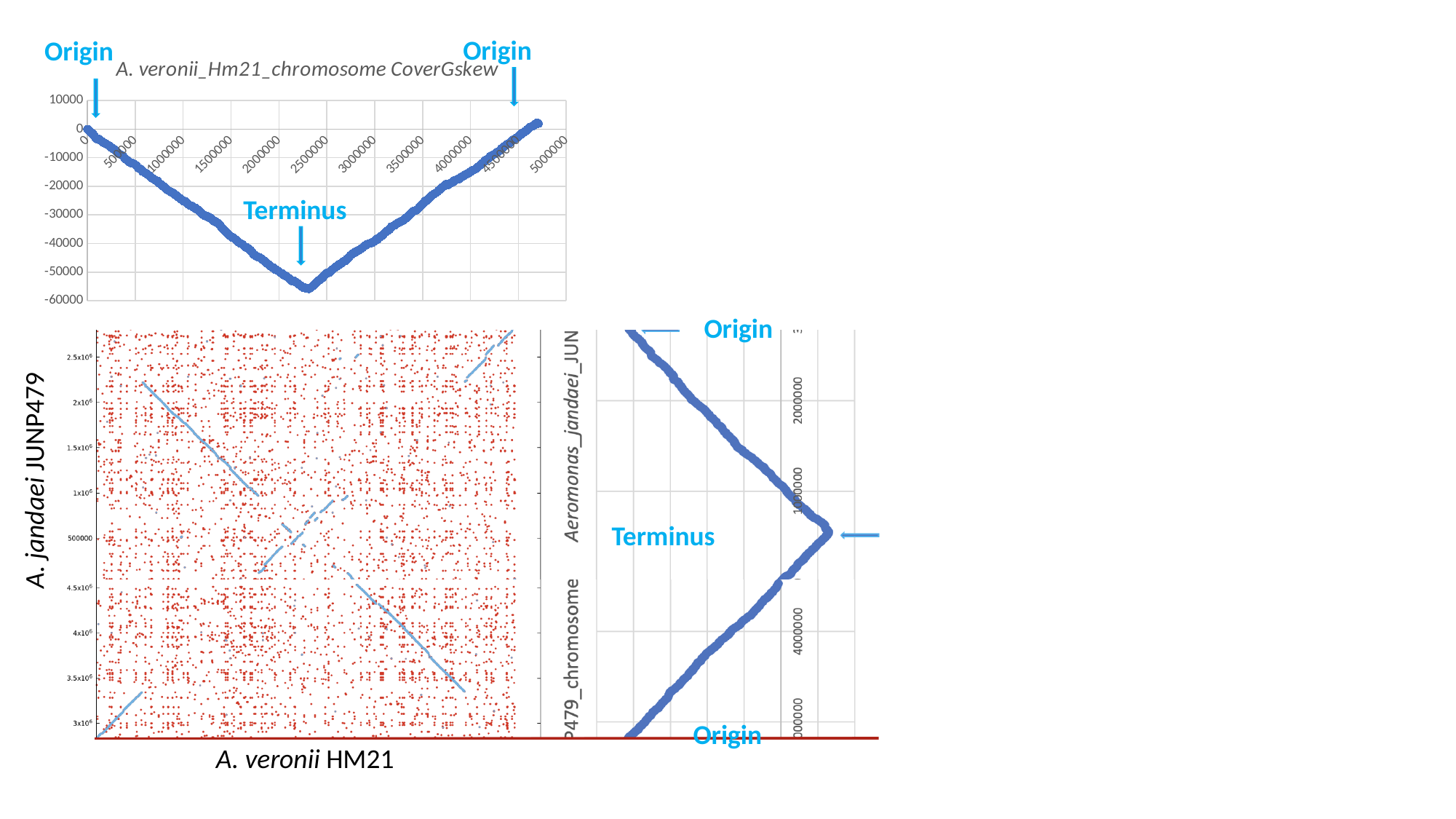
In the bottom-left dot plot, what is the label on the y axis? A. jandaei JUNP479 In the top chart (A. veronii_Hm21_chromosome CoverGskew), what is the largest tick label on the x axis? 5000000 In the top chart (A. veronii_Hm21_chromosome CoverGskew), do the values rise or fall along the x axis between 0 and 2500000? fall In the top chart (A. veronii_Hm21_chromosome CoverGskew), do the values rise or fall along the x axis between 2500000 and 5000000? rise In the top chart (A. veronii_Hm21_chromosome CoverGskew), what is the lowest value shown on the y axis? -60000 What is the title of the chart at the top of the slide? A. veronii_Hm21_chromosome CoverGskew In the top chart (A. veronii_Hm21_chromosome CoverGskew), which labelled point is marked at the minimum of the curve? Terminus In the bottom-left dot plot, what is the label on the x axis? A. veronii HM21 In the top chart (A. veronii_Hm21_chromosome CoverGskew), is the value at x = 4500000 greater or less than -10000? greater In the top chart (A. veronii_Hm21_chromosome CoverGskew), what kind of chart is shown? scatter chart In the top chart (A. veronii_Hm21_chromosome CoverGskew), is the value at x = 2000000 greater or less than -40000? less